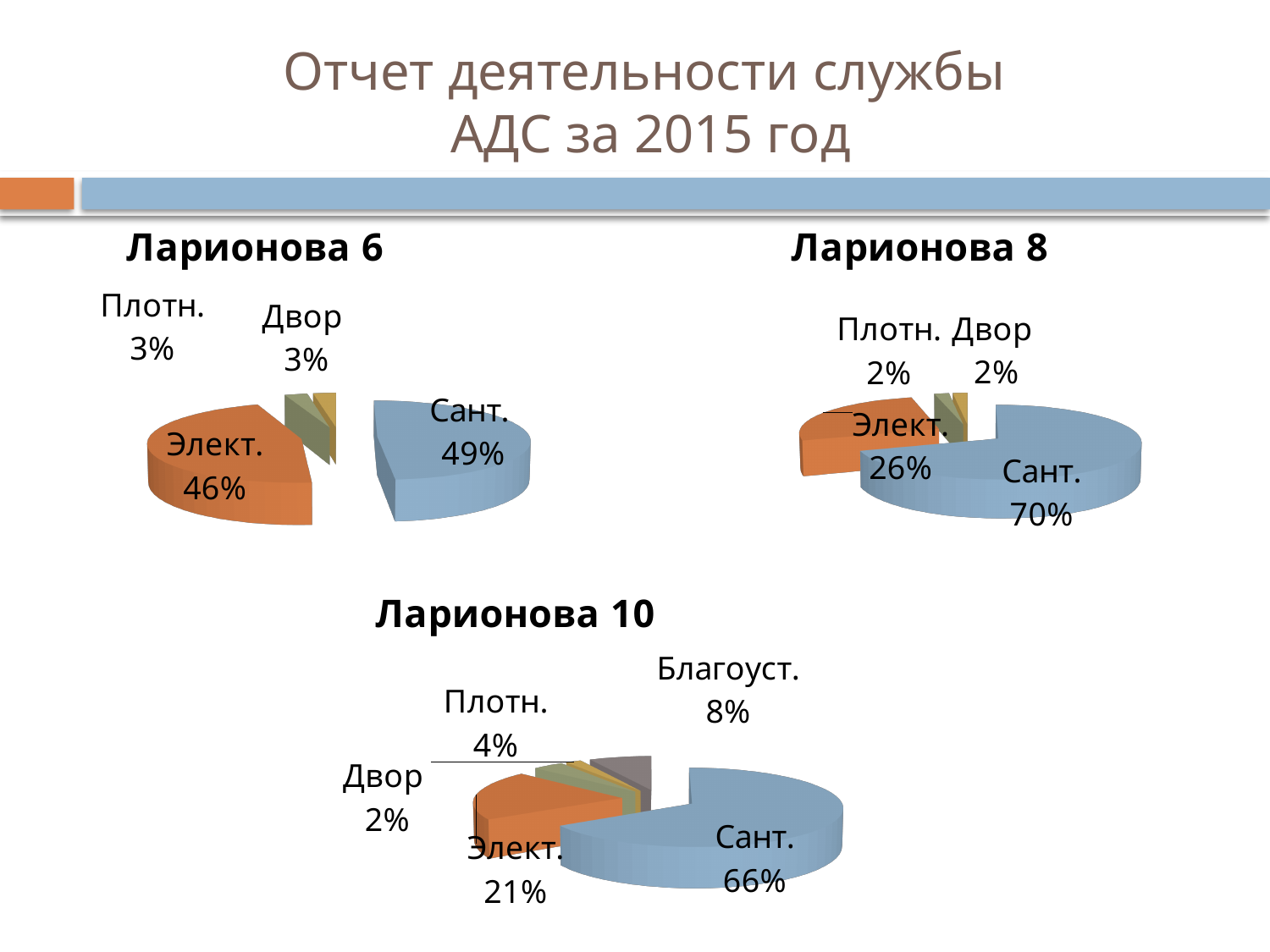
In the 'Ларионова 6' chart, what share does Элект. have? 46% In the 'Ларионова 10' chart, which is larger, Элект. or Благоуст.? Элект. What type of chart is the 'Ларионова 8' chart? Pie chart In the 'Ларионова 10' chart, which category has the smallest share? Двор In the 'Ларионова 8' chart, what share does Сант. have? 70% In the 'Ларионова 10' chart, what share does Благоуст. have? 8% In the 'Ларионова 10' chart, how many slices does the pie have? 5 In the 'Ларионова 6' chart, how many slices does the pie have? 4 In the 'Ларионова 8' chart, what is the difference between the shares of Сант. and Элект.? 44% In the 'Ларионова 8' chart, what share does Плотн. have? 2% In the 'Ларионова 6' chart, which category has the largest share? Сант. In the 'Ларионова 6' chart, what share does Сант. have? 49%